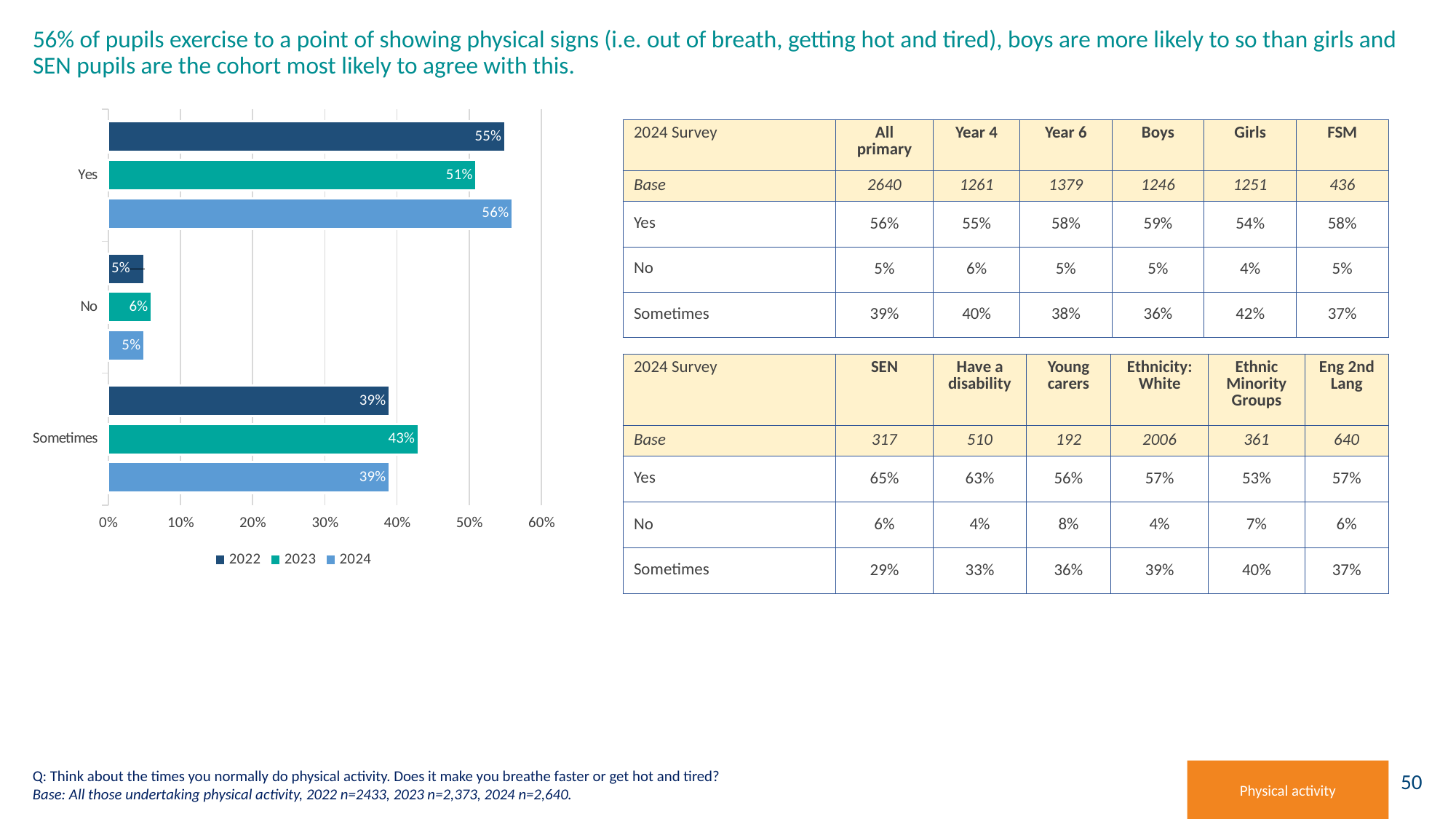
Is the 2022 value for 'Yes' greater or less than 50%? greater What are the series names listed in the legend? 2022, 2023, 2024 How many series does the legend list? 3 What is the value for 'No' in the 2022 series? 5% What is the value for 'Sometimes' in the 2023 series? 43% How many categories are shown on the chart? 3 What is the difference between the 2024 and 2023 values for 'Yes'? 5% What kind of chart is shown on the slide? bar chart Which is larger: the 2023 value for 'Sometimes' or the 2022 value for 'Sometimes'? 2023 Which category has the lowest value in the 2023 series? No What is the value for 'Yes' in the 2024 series? 56% Which category has the highest value in the 2024 series? Yes